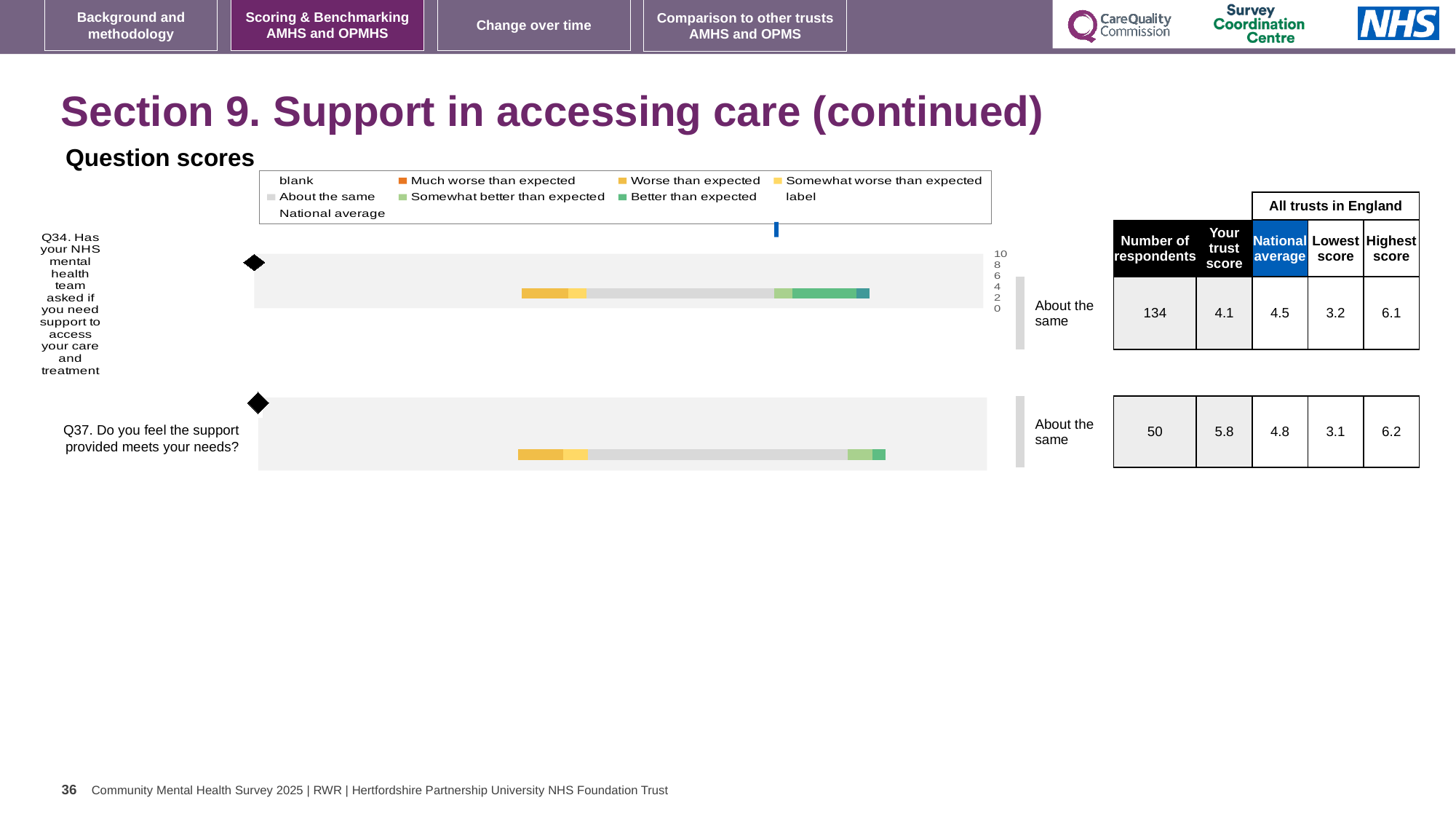
According to the table beside the chart, what is the trust score for Q37? 5.8 What kind of chart is used to show the question scores for Q34 and Q37? bar chart What benchmark category is shown next to the bar for Q34? About the same What is the difference between the trust scores for Q37 and Q34? 1.7 How many respondents answered Q34? 134 What is the national average score for Q37? 4.8 Which question has the higher trust score, Q34 or Q37? Q37 According to the table beside the chart, what is the trust score for Q34? 4.1 What benchmark category is shown next to the bar for Q37? About the same How many questions are plotted in the question scores chart? 2 In the chart legend, what colour represents 'Much worse than expected'? orange What is the highest score among all trusts in England for Q37? 6.2